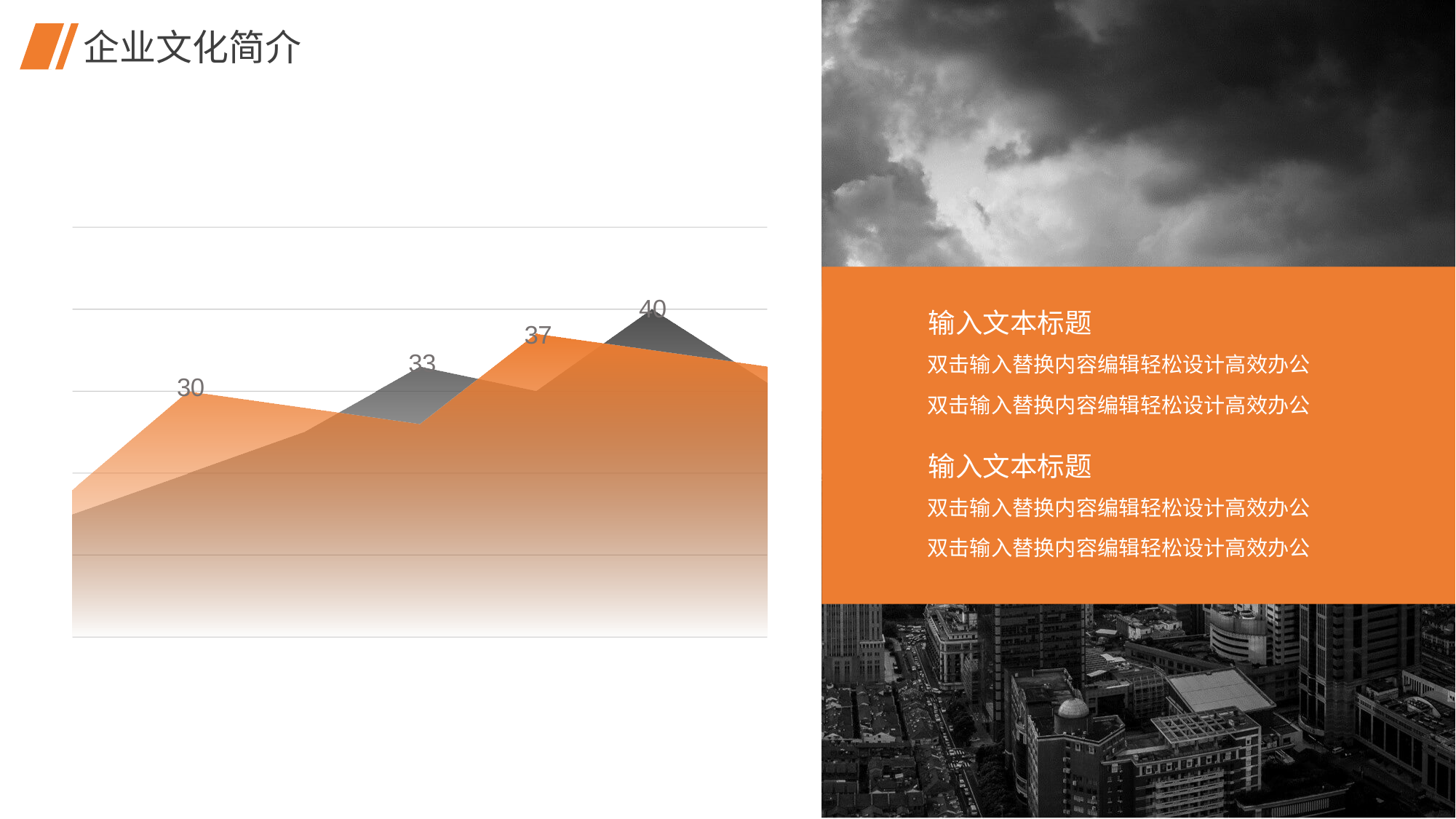
Which is larger, the point labeled 37 or the point labeled 40? 40 Which series colour has the peak labeled 30, orange or gray? orange Which series colour has the peak labeled 40, orange or gray? gray Which is larger, the point labeled 30 or the point labeled 33? 33 What is the difference between the highest labeled value (40) and the lowest labeled value (30)? 10 What is the lowest data label shown on the chart? 30 How many data labels are printed on the chart? 4 Do the labeled values rise or fall from left to right across the chart? rise What kind of chart is shown on the left of the slide? area chart What is the difference between the labeled values 37 and 33? 4 How many series are plotted on the chart? 2 What is the highest data label shown on the chart? 40